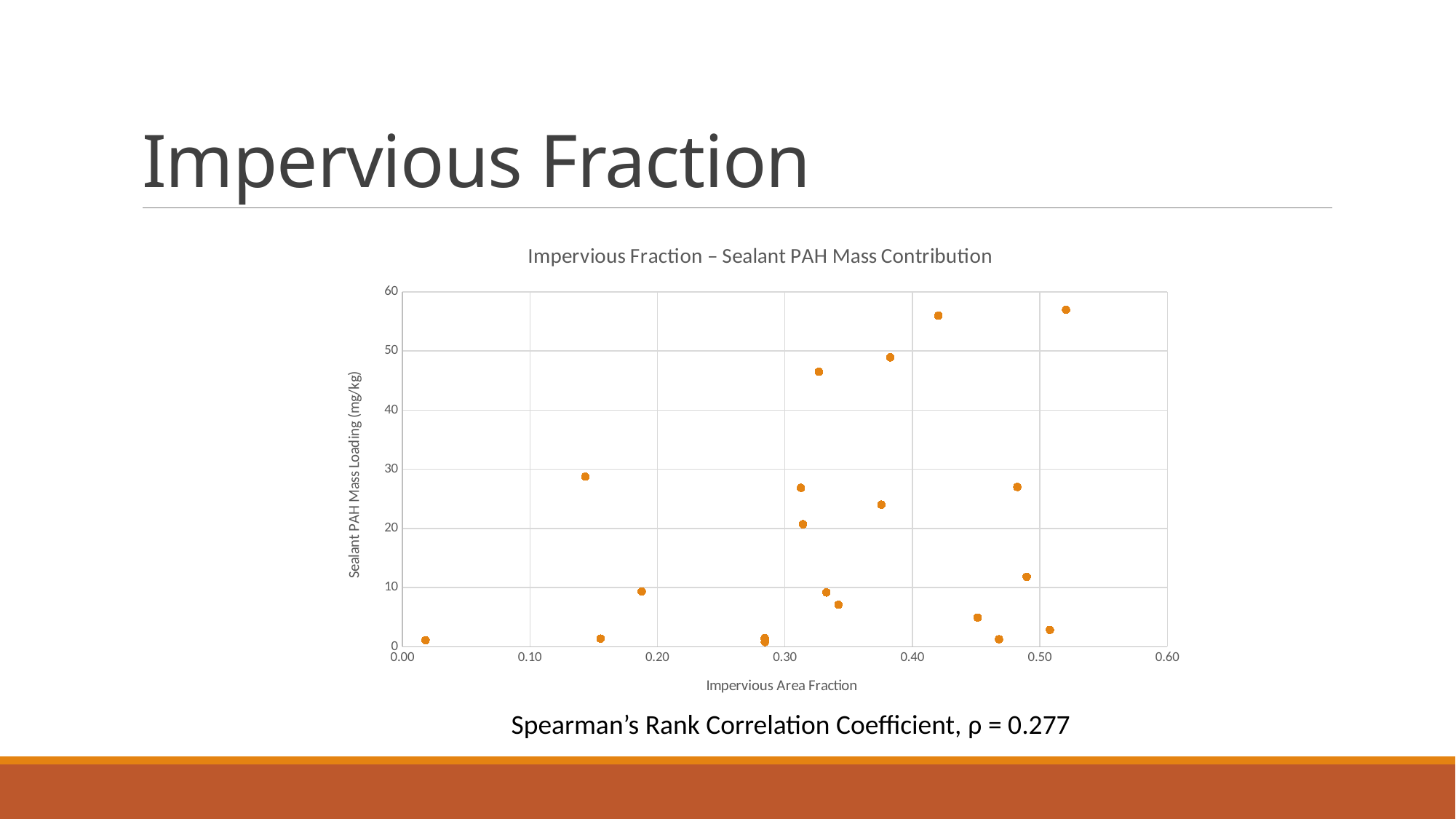
What value of Spearman's Rank Correlation Coefficient is stated below the chart? 0.277 Is the Sealant PAH Mass Loading for the point at an Impervious Area Fraction of about 0.19 greater or less than 20? less Is the Sealant PAH Mass Loading for the point at an Impervious Area Fraction of about 0.14 greater or less than 20? greater What is the title of the chart? Impervious Fraction – Sealant PAH Mass Contribution Is the Sealant PAH Mass Loading for the point with the smallest Impervious Area Fraction (about 0.02) greater or less than 10? less Which has the higher Sealant PAH Mass Loading: the point at an Impervious Area Fraction of about 0.52 or the point at about 0.02? the point at about 0.52 What is the maximum value shown on the y axis of the chart? 60 What is the maximum value shown on the x axis of the chart? 0.60 What kind of chart is shown on the slide? scatter plot Which has the higher Sealant PAH Mass Loading: the point at an Impervious Area Fraction of about 0.14 or the point at about 0.19? the point at about 0.14